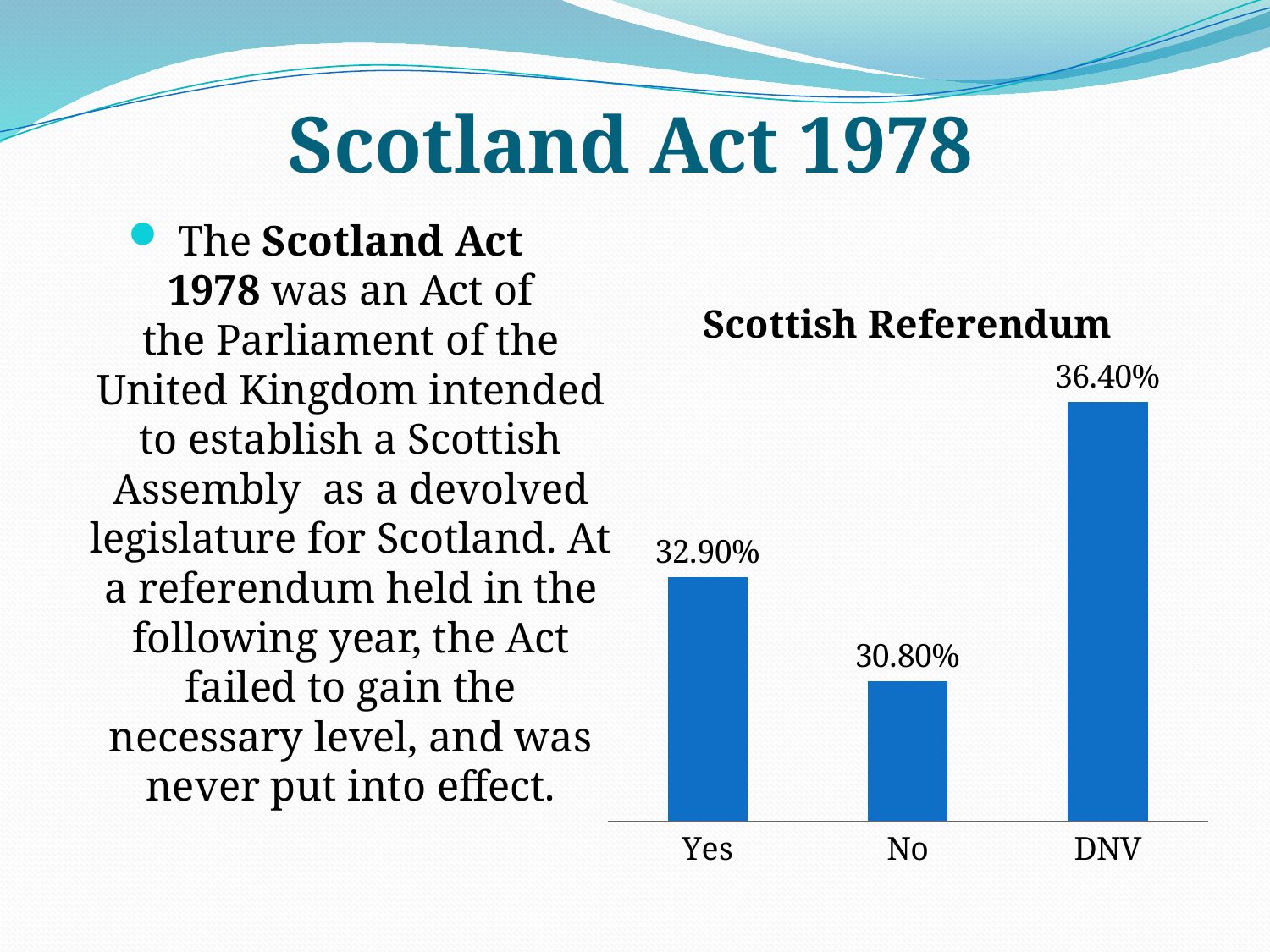
Which category has the lowest value in the Scottish Referendum chart? No What is the difference between the Yes and No values in the Scottish Referendum chart? 2.10% What is the difference between the DNV and Yes values in the Scottish Referendum chart? 3.50% What colour are the bars in the Scottish Referendum chart? Blue What is the title of the chart on the slide? Scottish Referendum What kind of chart is the Scottish Referendum chart? Bar chart What is the value for No in the Scottish Referendum chart? 30.80% How many categories are shown in the Scottish Referendum chart? 3 Which category has the highest value in the Scottish Referendum chart? DNV What is the value for Yes in the Scottish Referendum chart? 32.90% What is the value for DNV in the Scottish Referendum chart? 36.40% Which is larger in the Scottish Referendum chart, Yes or No? Yes